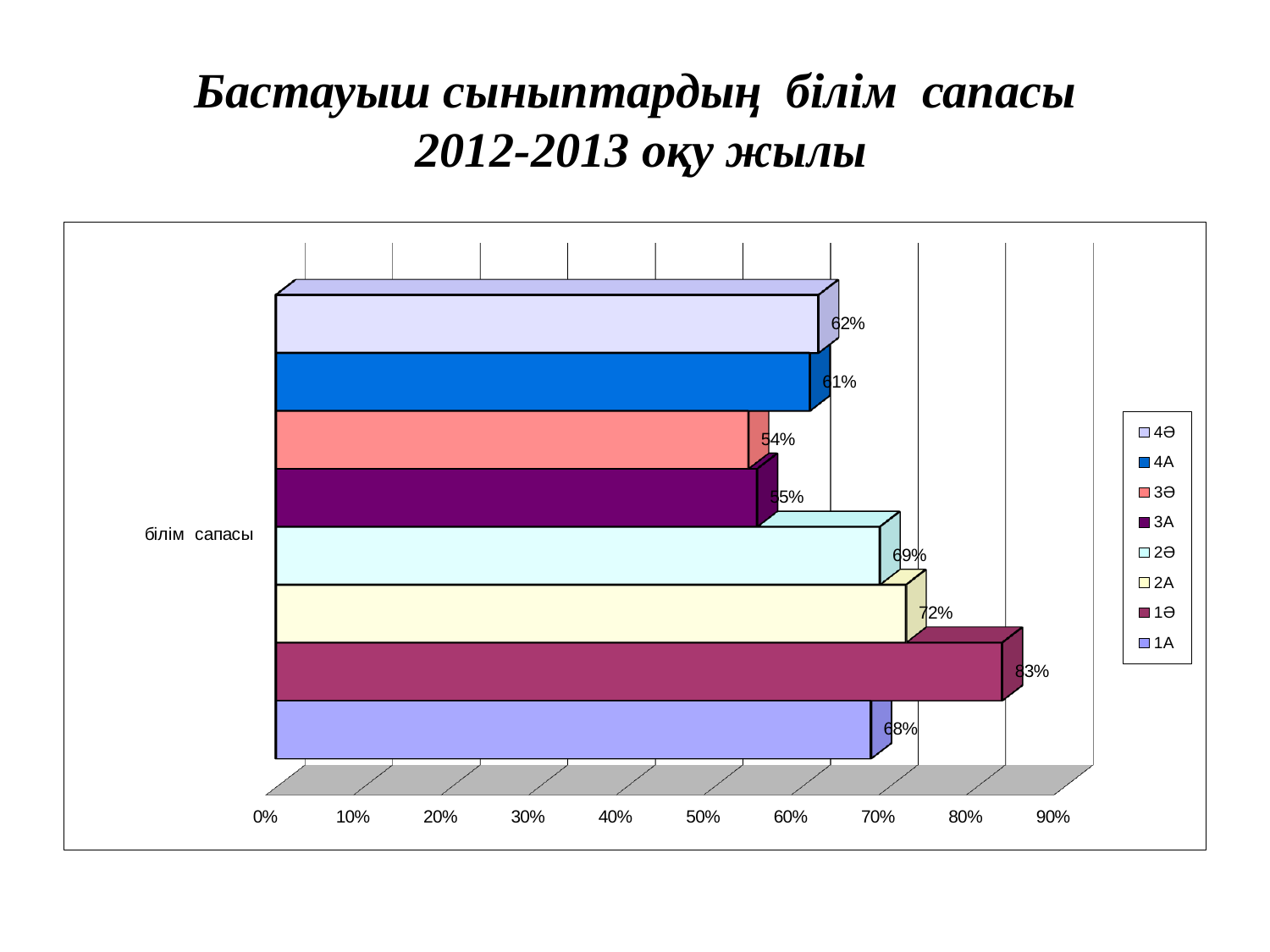
What is the title of the slide? Бастауыш сыныптардың білім сапасы 2012-2013 оқу жылы What is the value for 3Ә? 54% How many series does the legend list? 8 What is the difference between the values for 1Ә and 1А? 15% Which series has the lowest value? 3Ә What is the value for 1Ә? 83% What is the value for 4Ә? 62% Which series has the highest value? 1Ә Which is larger, the value for 2Ә or the value for 4А? 2Ә What kind of chart is shown on the slide? bar chart Is the value for 2А greater or less than 70%? greater What is the value for 2А? 72%